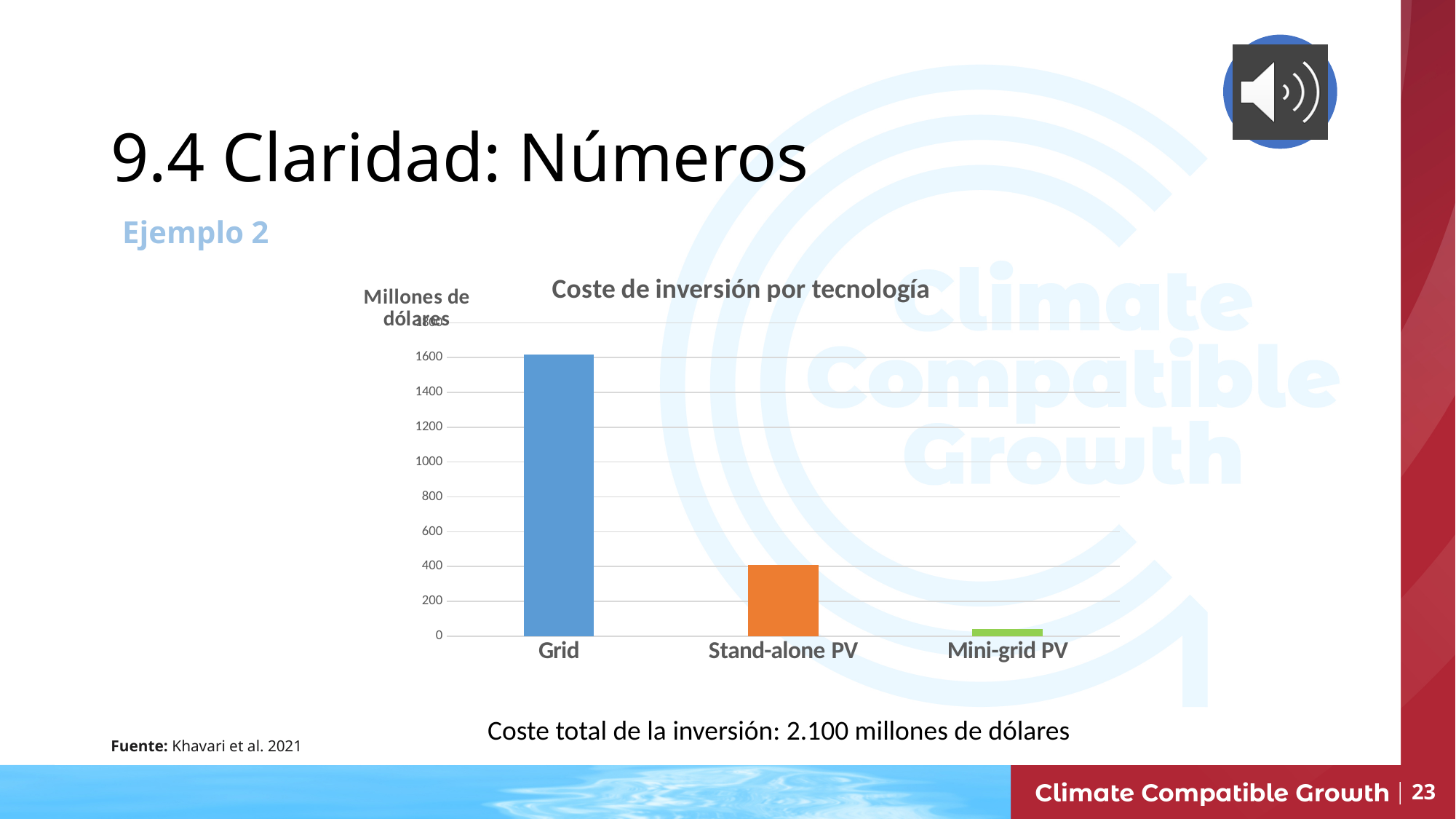
What is the title of the chart? Coste de inversión por tecnología Is the value for Stand-alone PV greater or less than 600? less What kind of chart is shown on the slide? Bar chart Which technology has the highest investment cost in the chart? Grid Is the value for Grid greater or less than 1400? greater What unit is given on the vertical axis label of the chart? Millones de dólares Do the bar values rise or fall from left to right across the categories? Fall Is the value for Mini-grid PV greater or less than 200? less How many technology categories are plotted in the chart? 3 Which has a larger investment cost, Stand-alone PV or Mini-grid PV? Stand-alone PV Which has a larger investment cost, Grid or Stand-alone PV? Grid Which technology has the lowest investment cost in the chart? Mini-grid PV